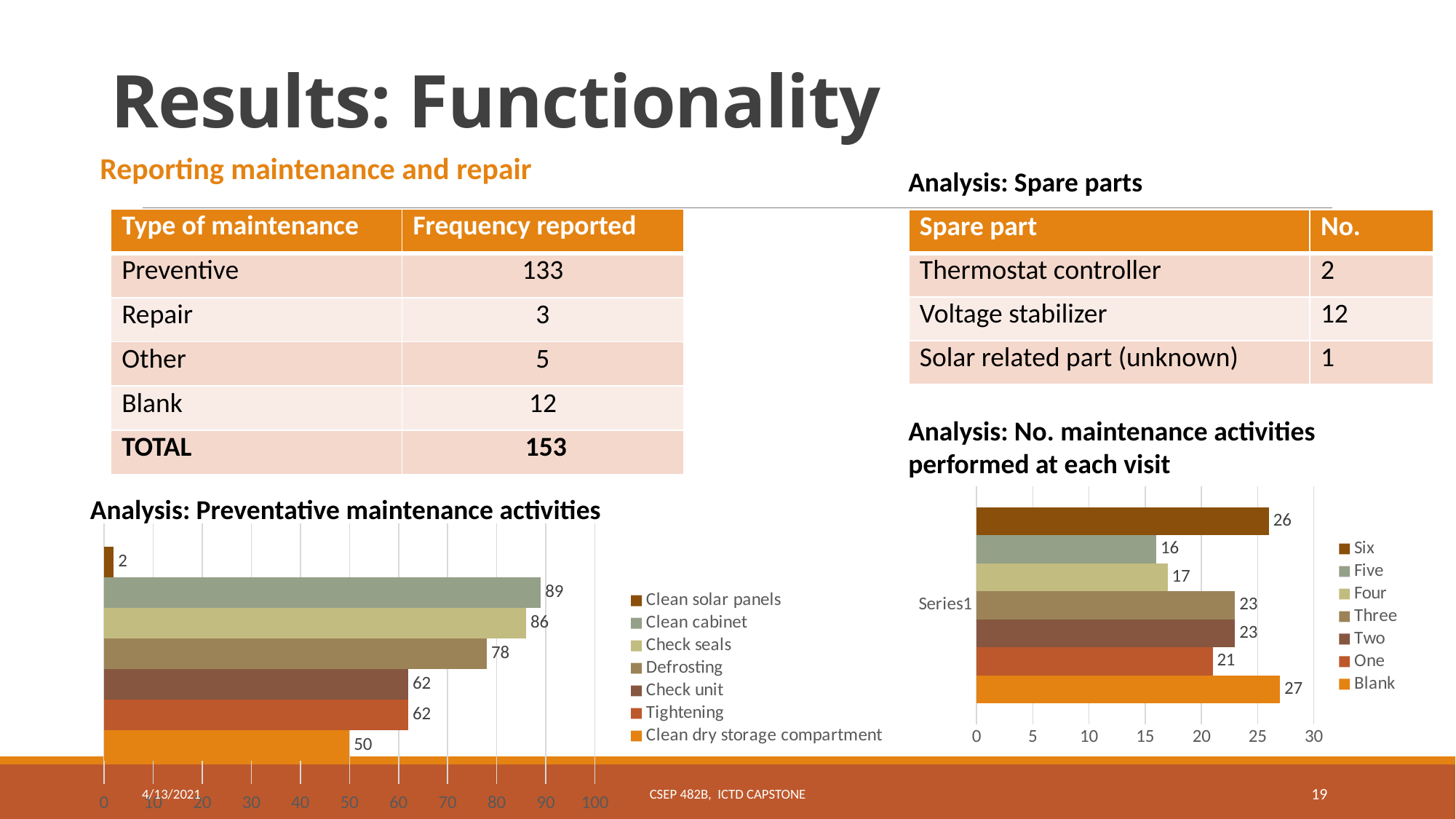
In the 'Analysis: Preventative maintenance activities' chart, what is the value for Clean dry storage compartment? 50 In the 'Analysis: No. maintenance activities performed at each visit' chart, what is the difference between Blank and Five? 11 In the 'Analysis: No. maintenance activities performed at each visit' chart, which legend entry has the highest value? Blank What kind of chart is 'Analysis: Preventative maintenance activities'? Bar chart In the 'Analysis: Preventative maintenance activities' chart, how many series does the legend list? 7 In the 'Analysis: No. maintenance activities performed at each visit' chart, which is larger, Four or One? One In the 'Analysis: Preventative maintenance activities' chart, which activity has the highest value? Clean cabinet In the 'Analysis: Preventative maintenance activities' chart, what is the difference between Clean cabinet and Defrosting? 11 In the 'Analysis: Preventative maintenance activities' chart, which activity has the lowest value? Clean solar panels In the 'Analysis: Preventative maintenance activities' chart, what is the value for Clean cabinet? 89 In the 'Analysis: No. maintenance activities performed at each visit' chart, which legend entry has the lowest value? Five In the 'Analysis: No. maintenance activities performed at each visit' chart, what is the value for Six? 26